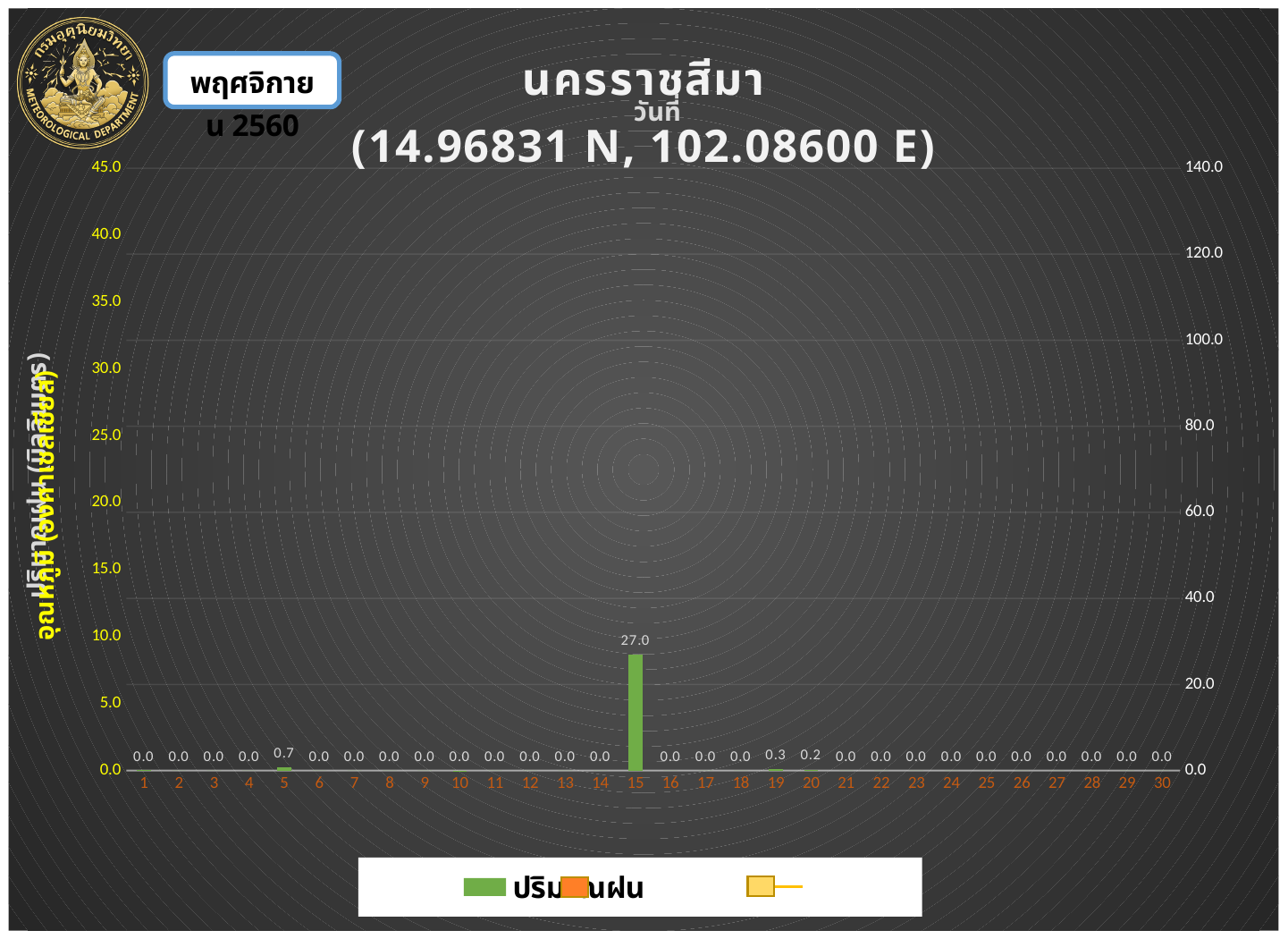
What is the difference between the rainfall values for day 15 and day 5? 26.3 What is the rainfall value for day 20? 0.2 What is the rainfall value for day 15? 27.0 How many days are shown on the x axis? 30 What is the rainfall value for day 1? 0.0 What type of chart is shown on the slide? bar chart What is the rainfall value for day 19? 0.3 Is the rainfall value for day 15 greater or less than 30.0 on the left axis? less What is the maximum value shown on the right-hand axis? 140.0 Which day has the highest rainfall value? 15 What is the rainfall value for day 5? 0.7 Which is larger, the rainfall value for day 19 or for day 20? day 19